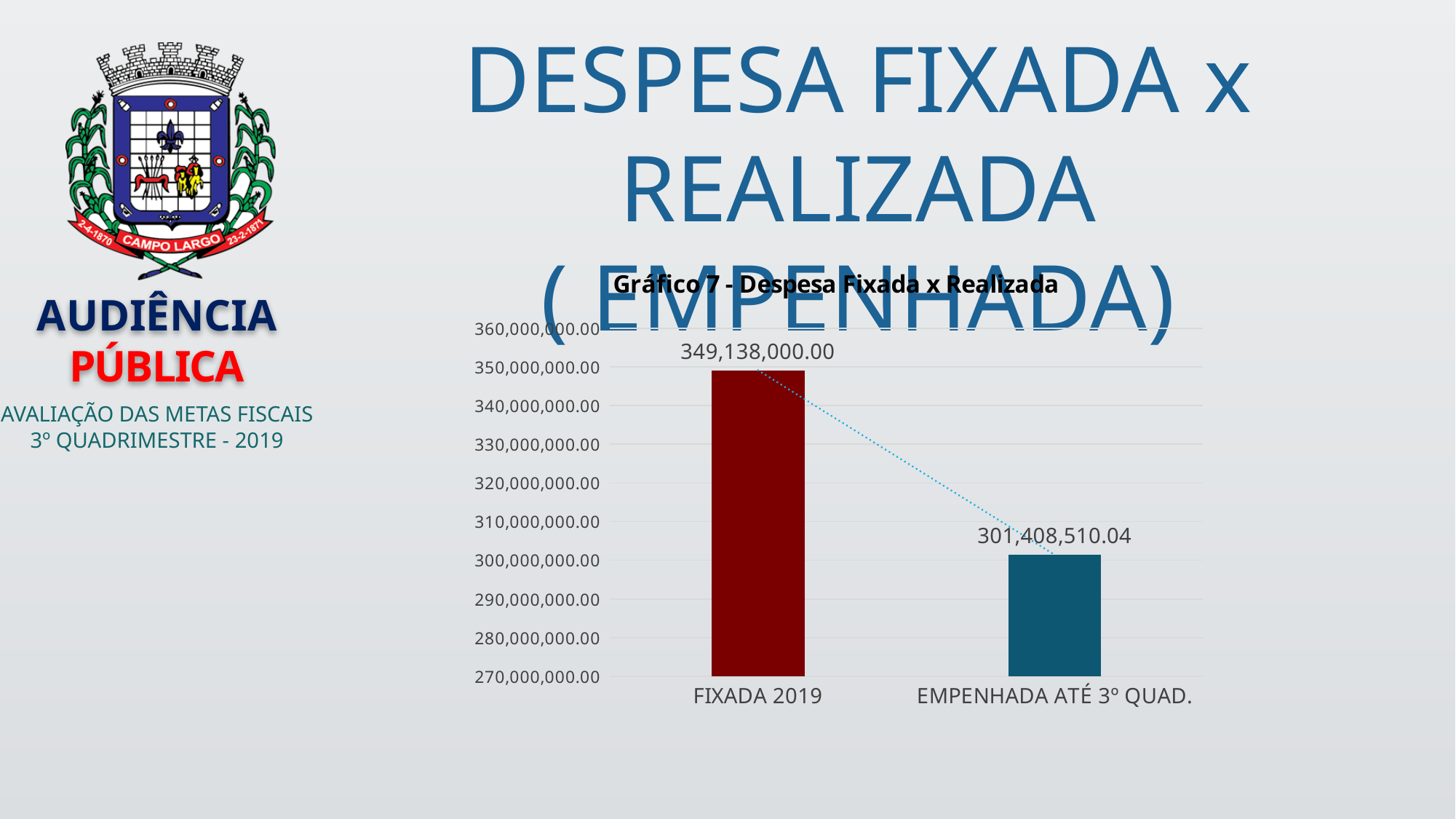
What is the difference between the value for FIXADA 2019 and the value for EMPENHADA ATÉ 3º QUAD.? 47,729,489.96 What kind of chart is shown on the slide? bar chart Which category has the highest value? FIXADA 2019 Which category has the lowest value? EMPENHADA ATÉ 3º QUAD. What is the value for EMPENHADA ATÉ 3º QUAD.? 301,408,510.04 Which is larger, the value for FIXADA 2019 or the value for EMPENHADA ATÉ 3º QUAD.? FIXADA 2019 Is the value for FIXADA 2019 greater or less than 340,000,000.00? greater Is the value for EMPENHADA ATÉ 3º QUAD. greater or less than 310,000,000.00? less How many categories are shown on the x axis of the chart? 2 What is the value for FIXADA 2019? 349,138,000.00 Do the values rise or fall from FIXADA 2019 to EMPENHADA ATÉ 3º QUAD.? fall What is the title of the chart? Gráfico 7 - Despesa Fixada x Realizada